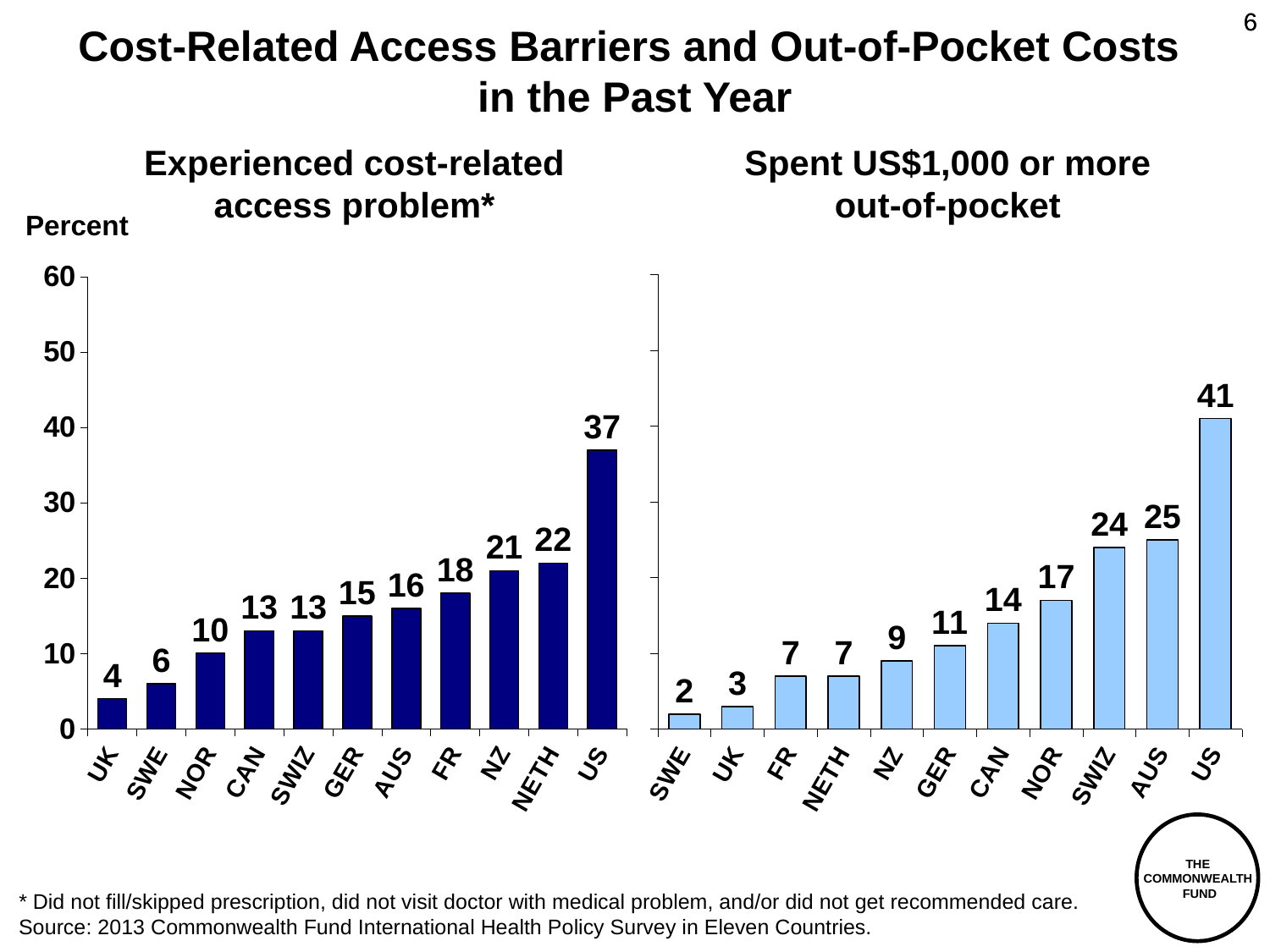
In the 'Spent US$1,000 or more out-of-pocket' chart, which is larger, the value for GER or the value for NOR? NOR In the 'Spent US$1,000 or more out-of-pocket' chart, which country has the highest value? US How many countries are shown in the 'Spent US$1,000 or more out-of-pocket' chart? 11 In the 'Experienced cost-related access problem' chart, which country has the lowest value? UK In the 'Experienced cost-related access problem' chart, what is the difference between the values for NETH and NOR? 12 In the 'Spent US$1,000 or more out-of-pocket' chart, do the values rise or fall from left to right? rise In the 'Spent US$1,000 or more out-of-pocket' chart, what is the difference between the values for US and SWIZ? 17 In the 'Spent US$1,000 or more out-of-pocket' chart, what is the value for AUS? 25 In the 'Experienced cost-related access problem' chart, is the value for FR greater or less than 20? less What kind of chart is the 'Experienced cost-related access problem' chart? bar chart In the 'Experienced cost-related access problem' chart, what is the value for the US? 37 What is the label on the vertical axis of the charts? Percent